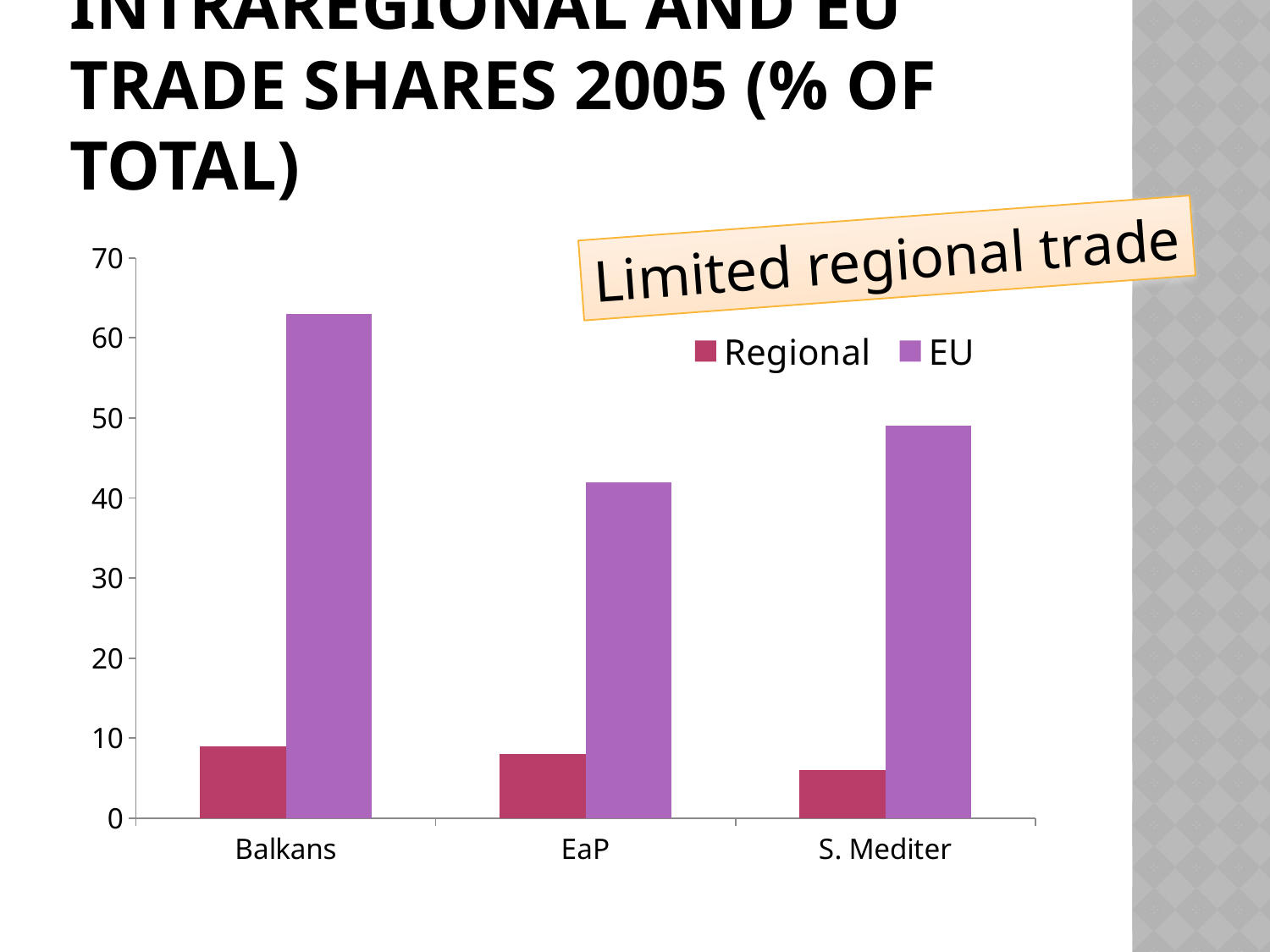
What kind of chart is shown on the slide? bar chart For Balkans, which series has the larger value, Regional or EU? EU Which is larger, the EU trade share for EaP or for S. Mediter? S. Mediter Which category has the lowest EU trade share? EaP How many categories are shown on the x axis? 3 Is the EU trade share for S. Mediter greater or less than 40? greater What are the two series named in the legend? Regional and EU Which category has the lowest Regional trade share? S. Mediter How many series does the legend list? 2 Is the EU trade share for Balkans greater or less than 60? greater Is the Regional trade share for EaP greater or less than 10? less Which category has the highest EU trade share? Balkans